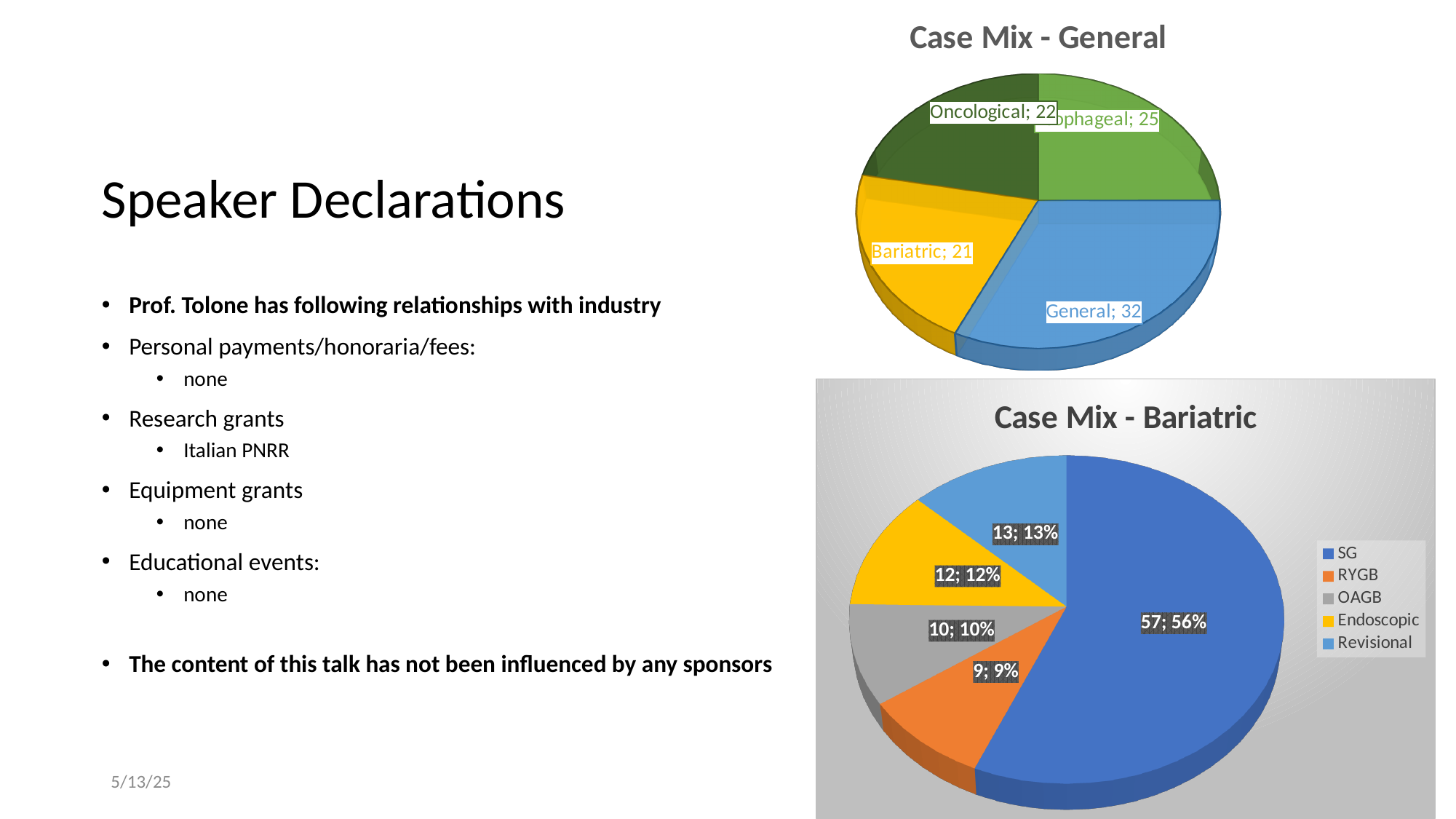
In the "Case Mix - General" chart, what is the value for Bariatric? 21 What kind of chart is "Case Mix - Bariatric"? Pie chart In the "Case Mix - Bariatric" chart, what is the difference between the Revisional and Endoscopic values? 1 In the "Case Mix - Bariatric" chart, which category has the smallest slice? RYGB In the "Case Mix - Bariatric" chart, what is the value for SG? 57 In the "Case Mix - General" chart, how many slices does the pie have? 4 In the "Case Mix - General" chart, what is the value for General? 32 In the "Case Mix - Bariatric" chart, how many entries does the legend list? 5 In the "Case Mix - General" chart, what is the difference between the General and Bariatric values? 11 In the "Case Mix - General" chart, what is the value for Oncological? 22 In the "Case Mix - General" chart, which category has the largest slice? General In the "Case Mix - Bariatric" chart, what percentage share does SG have? 56%